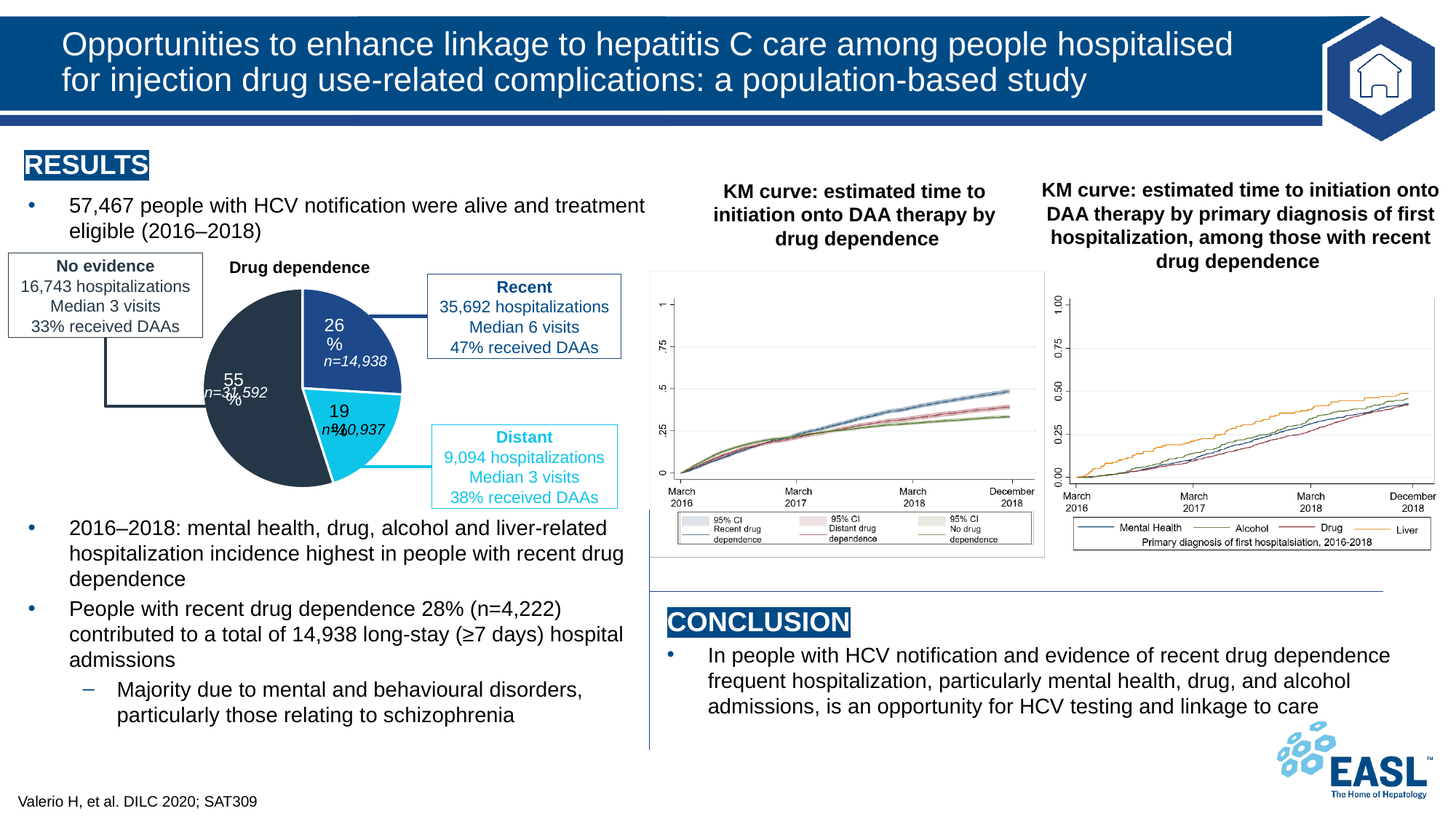
In the 'Drug dependence' pie chart, what percentage is the 'Distant' slice? 19% What kind of chart is the 'KM curve: estimated time to initiation onto DAA therapy by drug dependence' chart? line chart What kind of chart is the 'Drug dependence' chart on the left of the slide? pie chart In the 'Drug dependence' pie chart, which slice is the largest? No evidence In the 'KM curve: estimated time to initiation onto DAA therapy by primary diagnosis of first hospitalization' chart, is the value for 'Drug' at December 2018 greater or less than 0.50? less In the 'KM curve: estimated time to initiation onto DAA therapy by drug dependence' chart, which group has the highest curve at December 2018? Recent drug dependence In the 'Drug dependence' pie chart, what is the n value for the 'No evidence' slice? n=31,592 How many slices does the 'Drug dependence' pie chart have? 3 In the 'Drug dependence' pie chart, what is the difference in percentage points between the 'No evidence' slice and the 'Recent' slice? 29 How many series does the legend list in the 'KM curve: estimated time to initiation onto DAA therapy by primary diagnosis of first hospitalization' chart? 4 In the 'Drug dependence' pie chart, what percentage is the 'Recent' slice? 26% In the 'Drug dependence' pie chart, which slice is the smallest? Distant